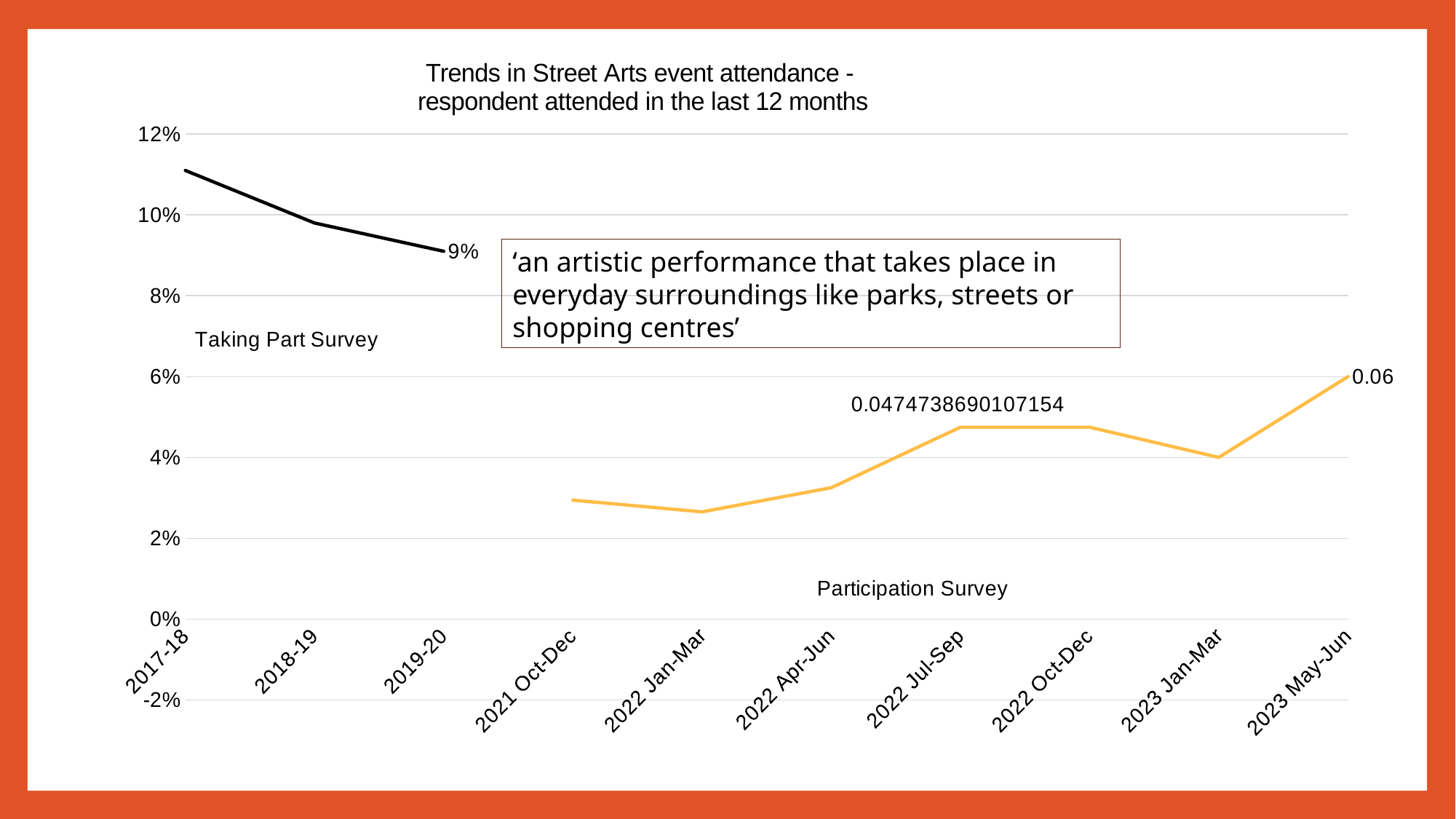
What is the Participation Survey value for 2023 May-Jun? 0.06 How many categories are shown on the x axis? 10 Does the Taking Part Survey line rise or fall from 2017-18 to 2019-20? fall Which category has the highest Participation Survey value? 2023 May-Jun What is the Taking Part Survey value for 2019-20? 9% What kind of chart is shown on the slide? line chart Which category has the lowest Participation Survey value? 2022 Jan-Mar Is the Participation Survey value for 2022 Jan-Mar greater or less than 4%? less What is the title of the chart? Trends in Street Arts event attendance - respondent attended in the last 12 months Is the Taking Part Survey value for 2017-18 greater or less than 10%? greater Which is larger: the Taking Part Survey value for 2019-20 or the Participation Survey value for 2023 May-Jun? Taking Part Survey value for 2019-20 What data label is shown for the Participation Survey at 2022 Jul-Sep? 0.0474738690107154